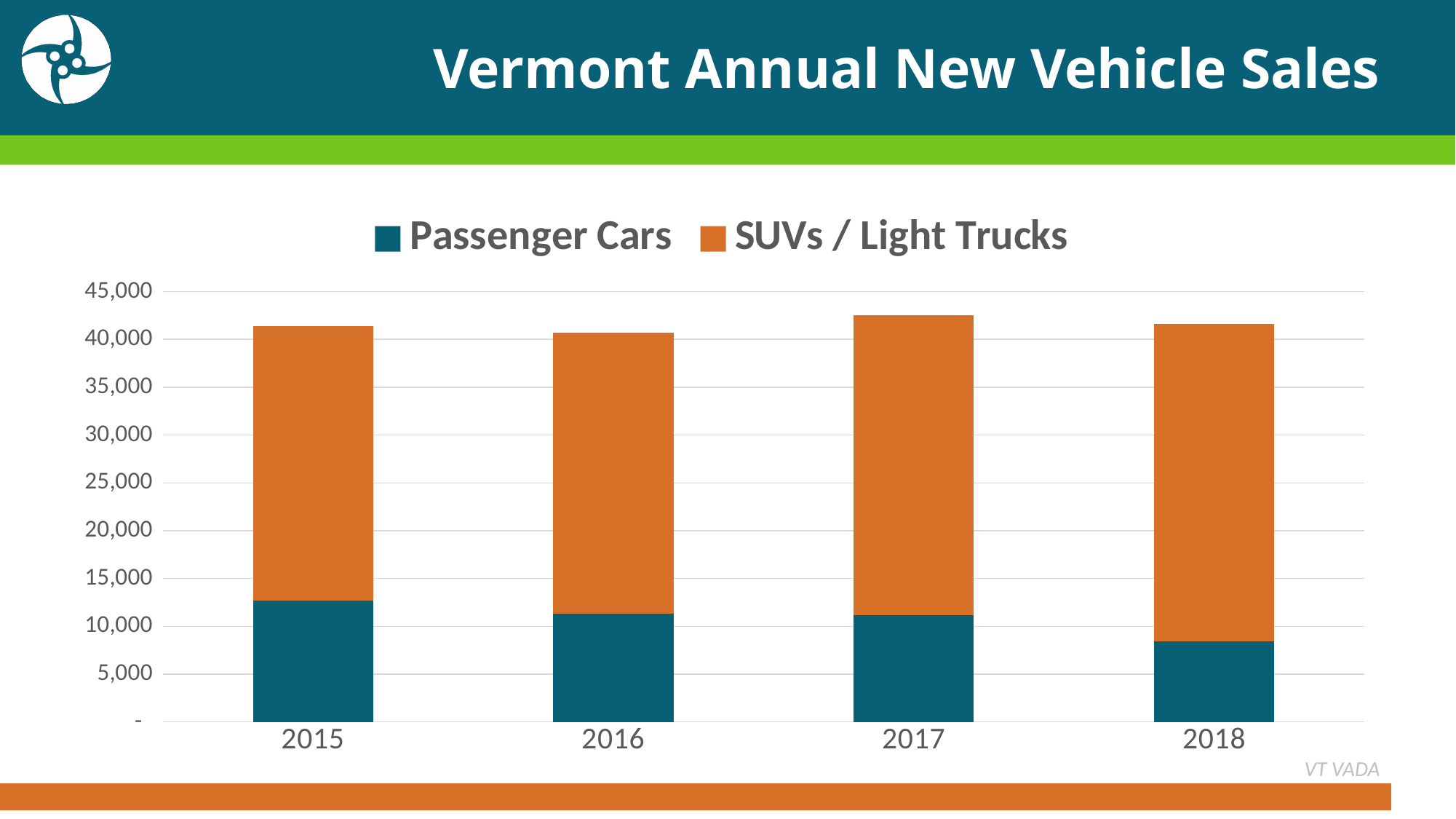
Which year has the highest total new vehicle sales? 2017 What is the title of the slide? Vermont Annual New Vehicle Sales Do Passenger Cars sales rise or fall from 2015 to 2018? fall Which year has the lowest Passenger Cars sales? 2018 Which series is shown in orange? SUVs / Light Trucks Is the total bar height for 2017 greater or less than 40,000? greater Is the Passenger Cars value for 2018 greater or less than 10,000? less Which year has the highest Passenger Cars sales? 2015 How many series does the legend list? 2 Is the Passenger Cars value for 2015 greater or less than 10,000? greater How many years are shown on the x axis? 4 What kind of chart is shown on the slide? stacked bar chart